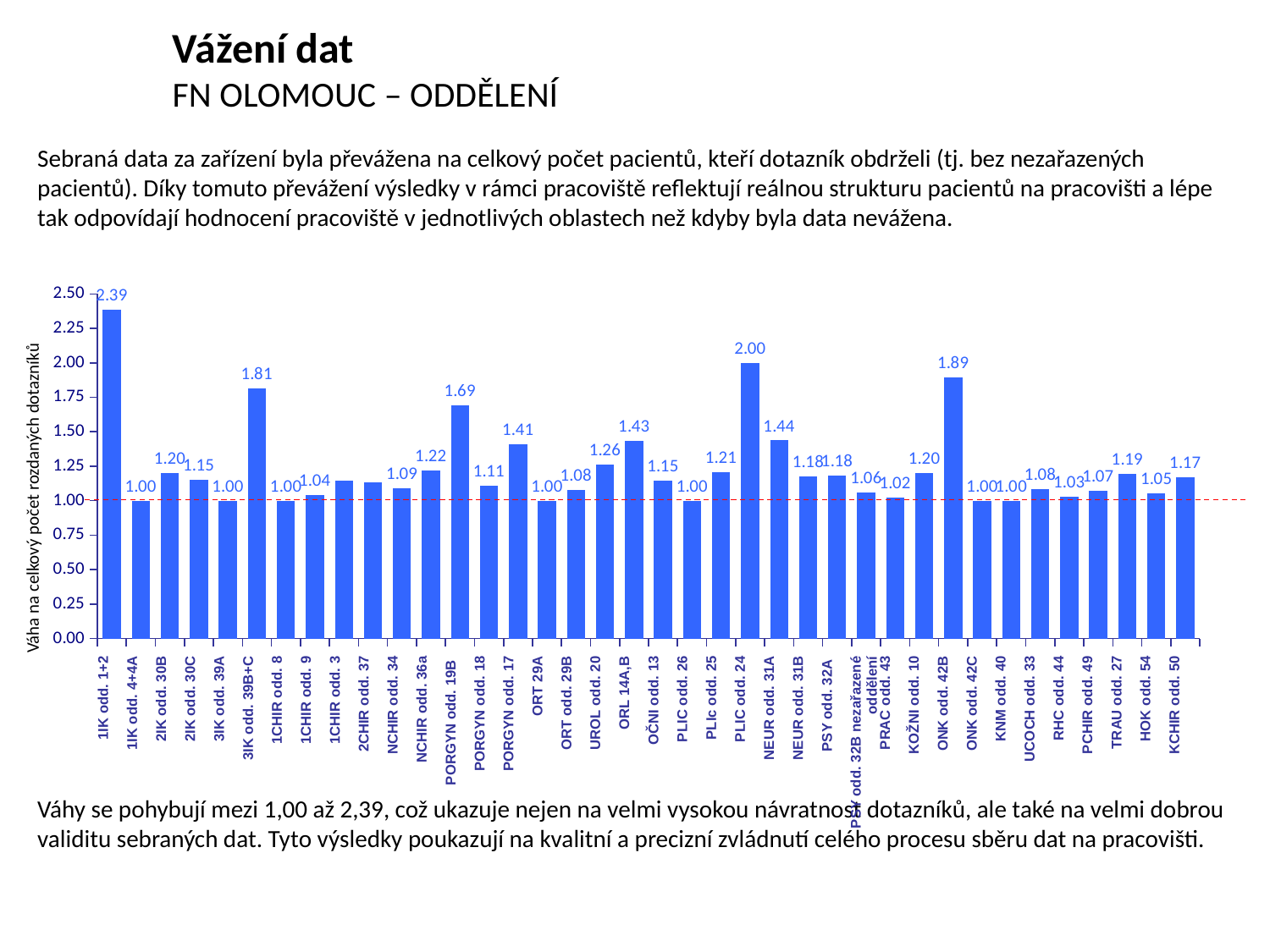
What is the label of the vertical axis of the chart? Váha na celkový počet rozdaných dotazníků Which has a larger weight, NEUR odd. 31A or UROL odd. 20? NEUR odd. 31A Is the value for 1CHIR odd. 3 greater or less than 1.00? greater Which department has the highest weight in the chart? 1IK odd. 1+2 What type of chart is shown on the slide? Bar chart At what value is the red dashed horizontal line drawn on the chart? 1.00 What is the weight value shown for PORGYN odd. 19B? 1.69 What is the weight value shown for 3IK odd. 39B+C? 1.81 What is the weight value shown for ONK odd. 42B? 1.89 What is the difference between the weights for 1IK odd. 1+2 and PLIC odd. 24? 0.39 What is the weight value shown for 1IK odd. 1+2? 2.39 What is the weight value shown for PLIC odd. 24? 2.00